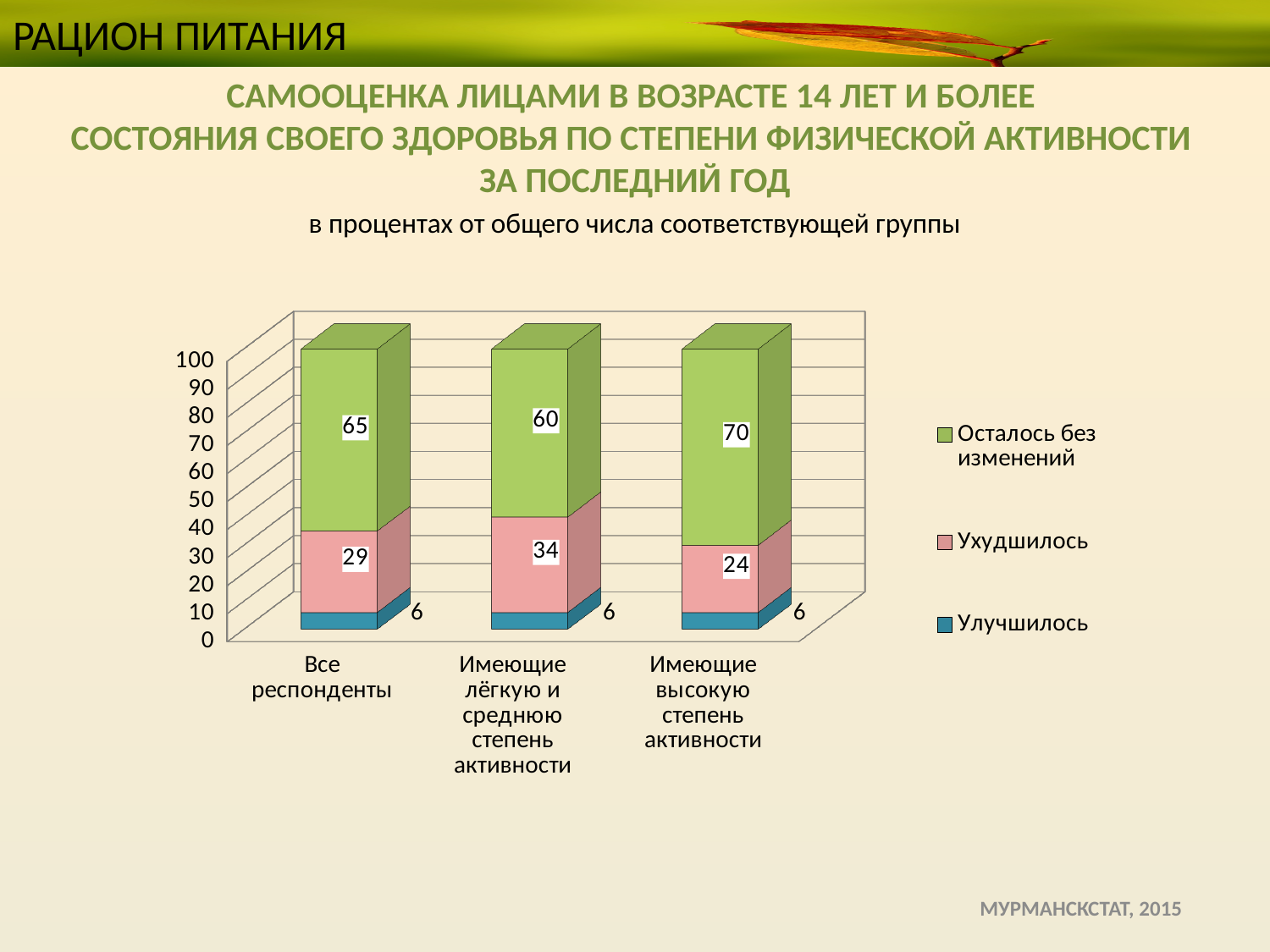
What is the difference between the "Ухудшилось" values for "Имеющие лёгкую и среднюю степень активности" and "Имеющие высокую степень активности"? 10 What is the total of the stacked bar for "Все респонденты"? 100 What is the value of "Осталось без изменений" for "Все респонденты"? 65 How many series does the legend list? 3 Which category has the lowest value for "Ухудшилось"? Имеющие высокую степень активности Which category has the highest value for "Осталось без изменений"? Имеющие высокую степень активности Which is larger: the "Осталось без изменений" value for "Все респонденты" or for "Имеющие лёгкую и среднюю степень активности"? Все респонденты What is the value of "Ухудшилось" for "Имеющие лёгкую и среднюю степень активности"? 34 What kind of chart is shown on the slide? Stacked bar chart What is the value of "Улучшилось" for "Имеющие высокую степень активности"? 6 Which series is shown in green in the legend? Осталось без изменений How many categories are shown on the x axis? 3